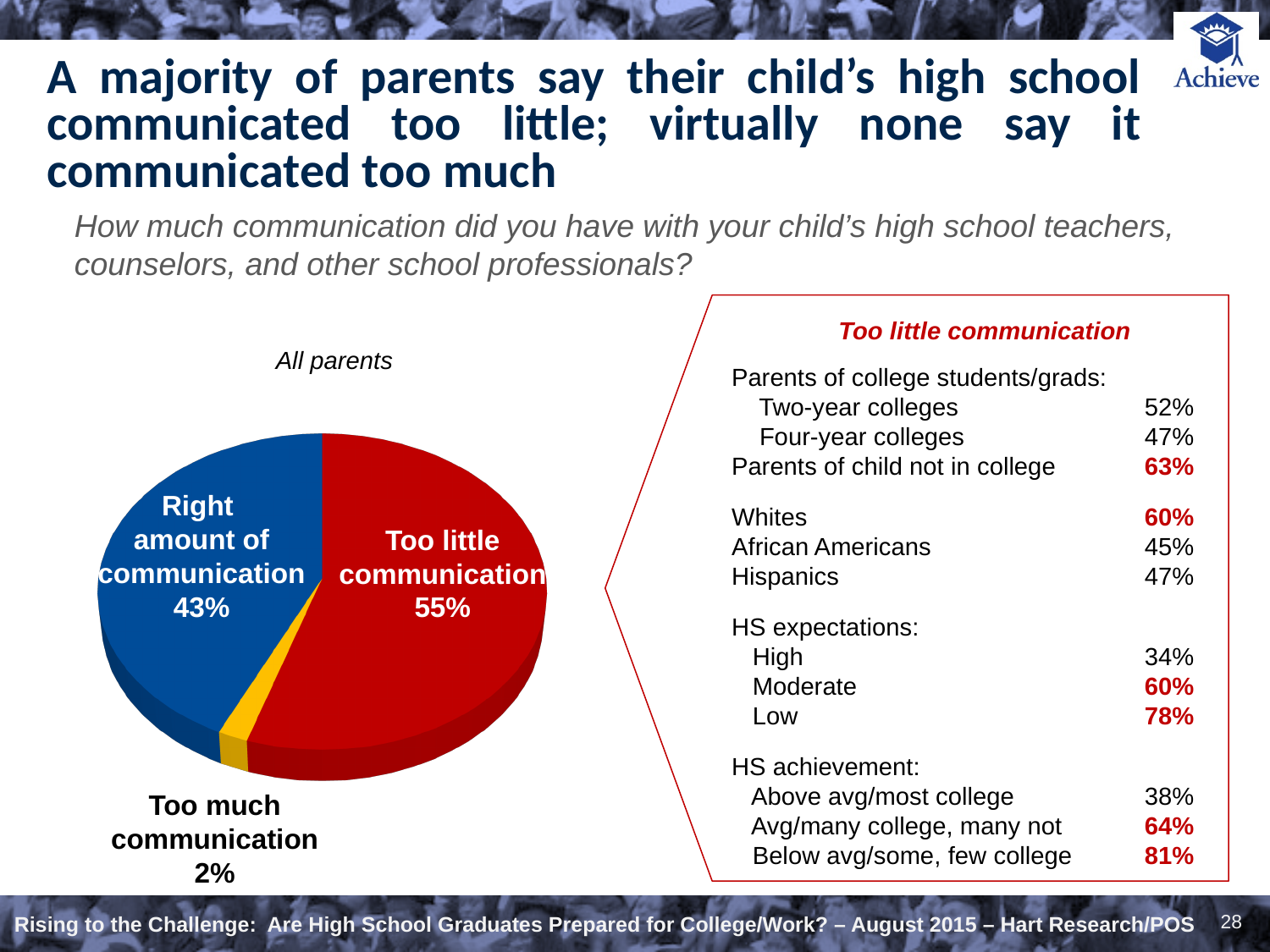
What colour is the 'Too little communication' slice? Red What percentage of all parents say there was the right amount of communication? 43% Which is larger: the share for 'Right amount of communication' or 'Too much communication'? Right amount of communication What type of chart is shown on the slide? Pie chart What is the difference in percentage points between 'Too little communication' and 'Right amount of communication'? 12 Is the share for 'Too little communication' greater or less than 50%? greater What is the label above the pie chart indicating the group shown? All parents What percentage of all parents say there was too little communication? 55% What percentage of all parents say there was too much communication? 2% Which response has the smallest share of the pie chart? Too much communication How many slices does the pie chart have? 3 Which response has the largest share of the pie chart? Too little communication